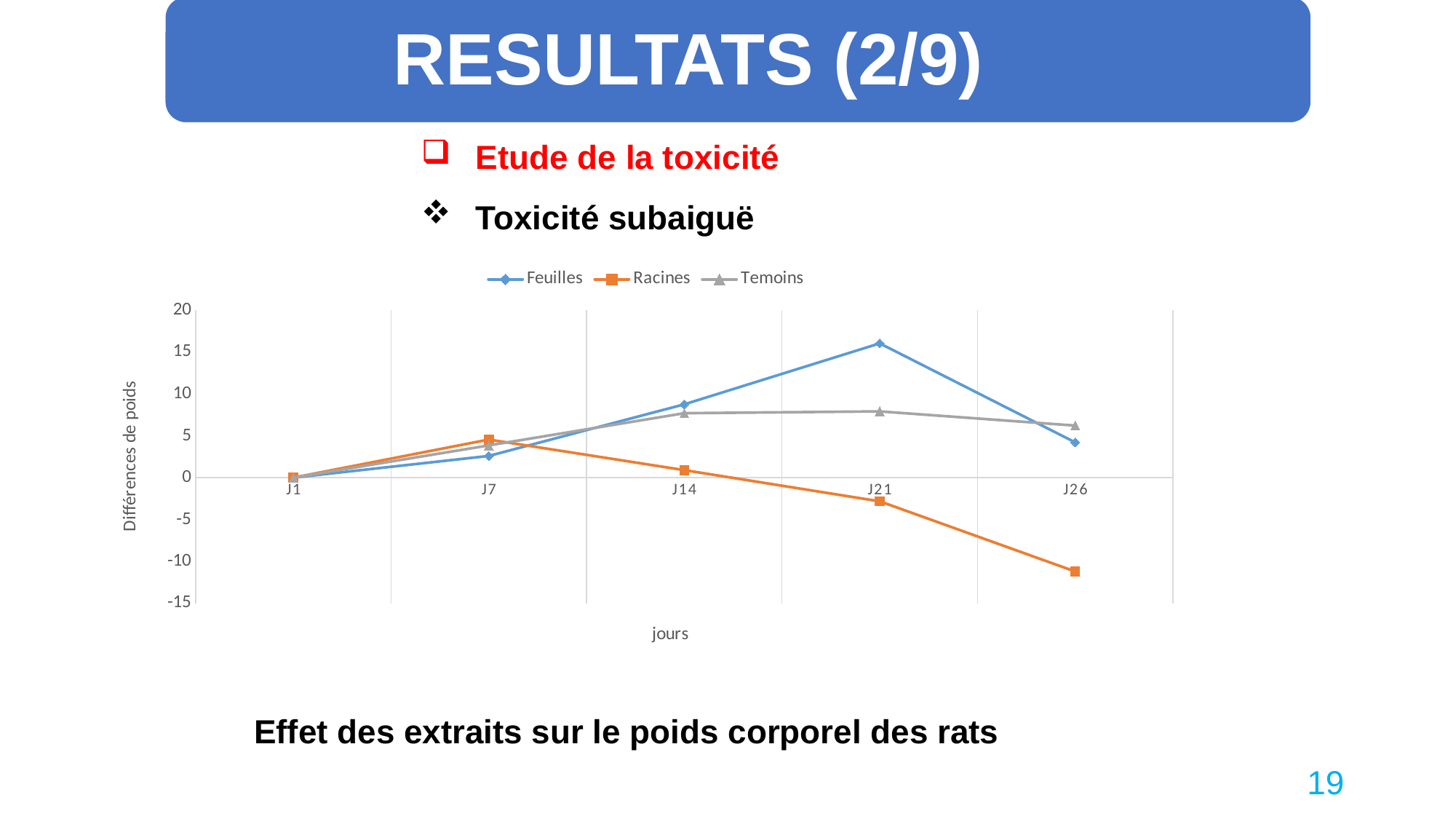
Does the Racines series rise or fall from J7 to J26? fall Is the value for Racines at J26 greater or less than -5? less What is the value for Racines at J1? 0 At which day does the Racines series reach its lowest value? J26 At J21, which series has the larger value, Feuilles or Racines? Feuilles How many series does the legend list? 3 How many points (days) are plotted along the x axis? 5 At which day does the Feuilles series reach its highest value? J21 Is the value for Feuilles at J21 greater or less than 10? greater What is the title of the y axis? Différences de poids Is the value for Temoins at J14 greater or less than 5? greater What kind of chart is shown on the slide? line chart